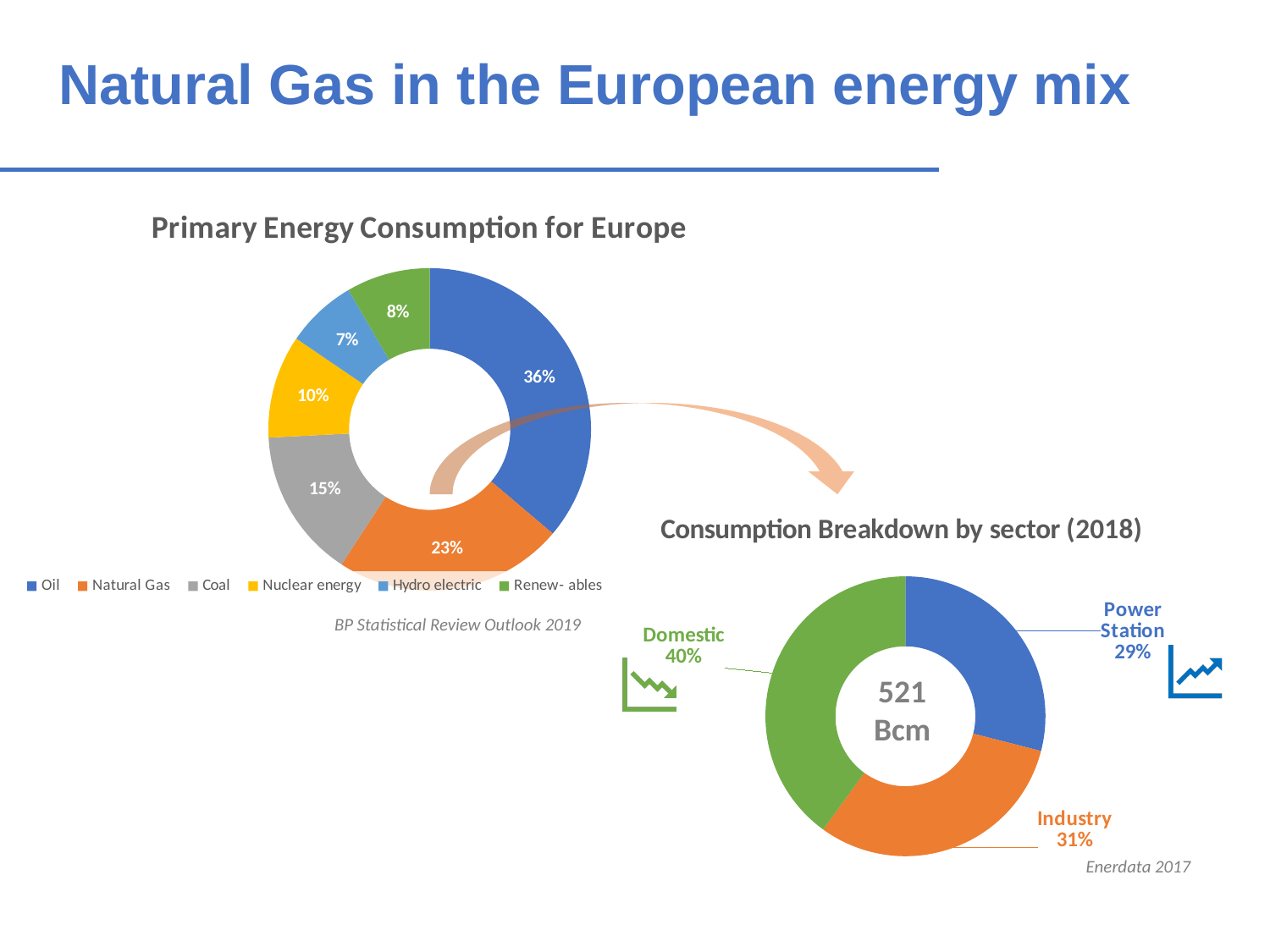
In the 'Primary Energy Consumption for Europe' chart, what is the difference between the Oil share and the Natural Gas share? 13% In the 'Primary Energy Consumption for Europe' chart, how many energy sources does the legend list? 6 In the 'Primary Energy Consumption for Europe' chart, which energy source has the largest share? Oil In the 'Consumption Breakdown by sector (2018)' chart, which sector has the largest share? Domestic In the 'Consumption Breakdown by sector (2018)' chart, what total volume is shown in the centre of the chart? 521 Bcm In the 'Consumption Breakdown by sector (2018)' chart, what share does Power Station have? 29% In the 'Primary Energy Consumption for Europe' chart, what share does Natural Gas have? 23% In the 'Consumption Breakdown by sector (2018)' chart, what share does Domestic have? 40% In the 'Primary Energy Consumption for Europe' chart, what share does Oil have? 36% What kind of chart is the 'Consumption Breakdown by sector (2018)' chart? doughnut chart In the 'Primary Energy Consumption for Europe' chart, what share does Coal have? 15% In the 'Primary Energy Consumption for Europe' chart, which energy source has the smallest share? Hydro electric